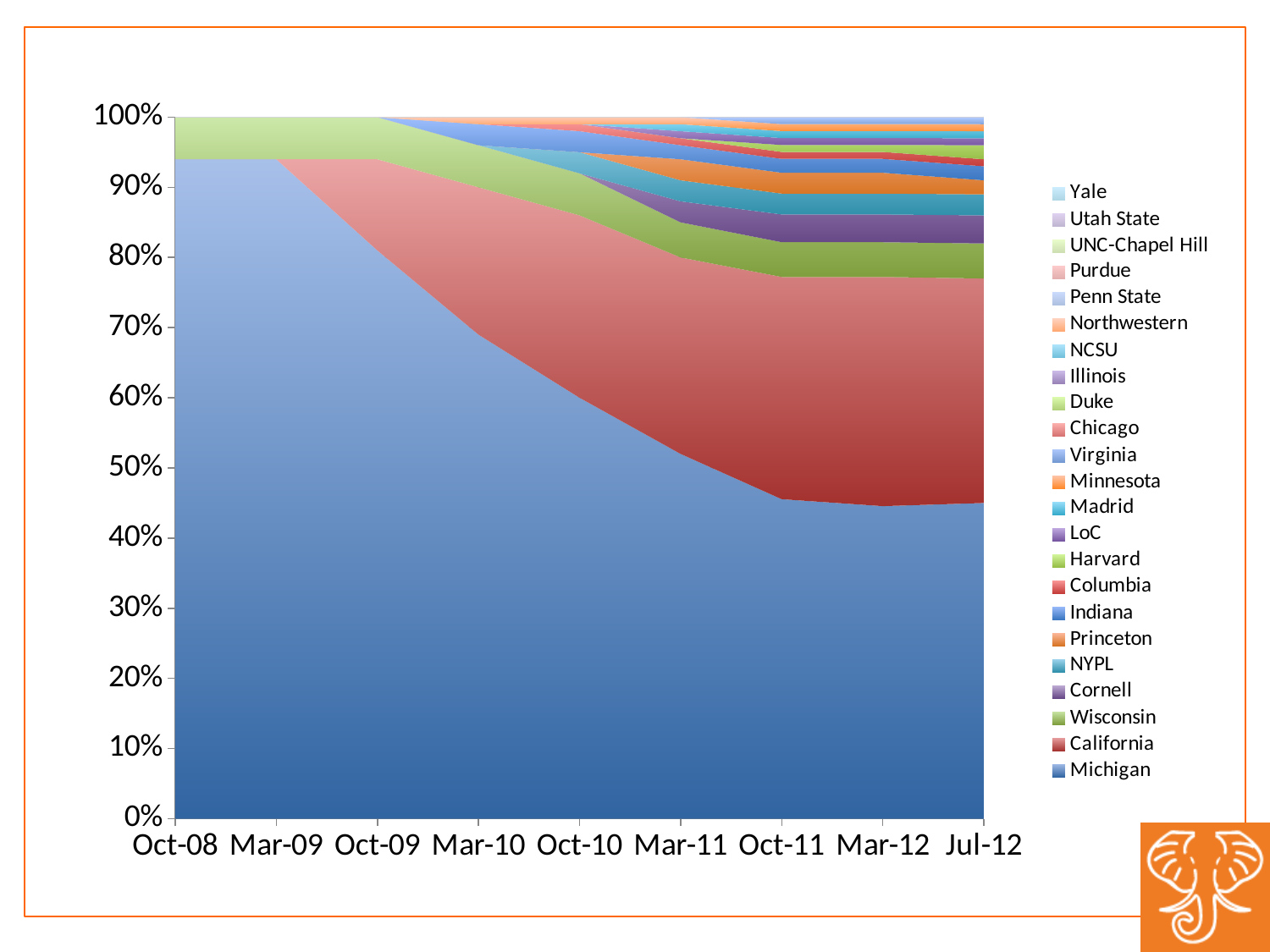
What kind of chart is shown on the slide? Stacked area chart Which series has the largest share at Oct-08? Michigan How many series does the legend list? 23 How many time points are labelled on the x axis? 9 Is the share for Michigan at Oct-08 greater or less than 90%? greater At Jul-12, which has the larger share, Michigan or California? Michigan Is the share for Michigan at Mar-11 greater or less than 60%? less Which series is listed first in the legend? Yale Does the share for Michigan rise or fall from Oct-08 to Jul-12? Fall What is the first time point labelled on the x axis? Oct-08 Which series is listed last in the legend? Michigan Is the share for Michigan at Jul-12 greater or less than 50%? less